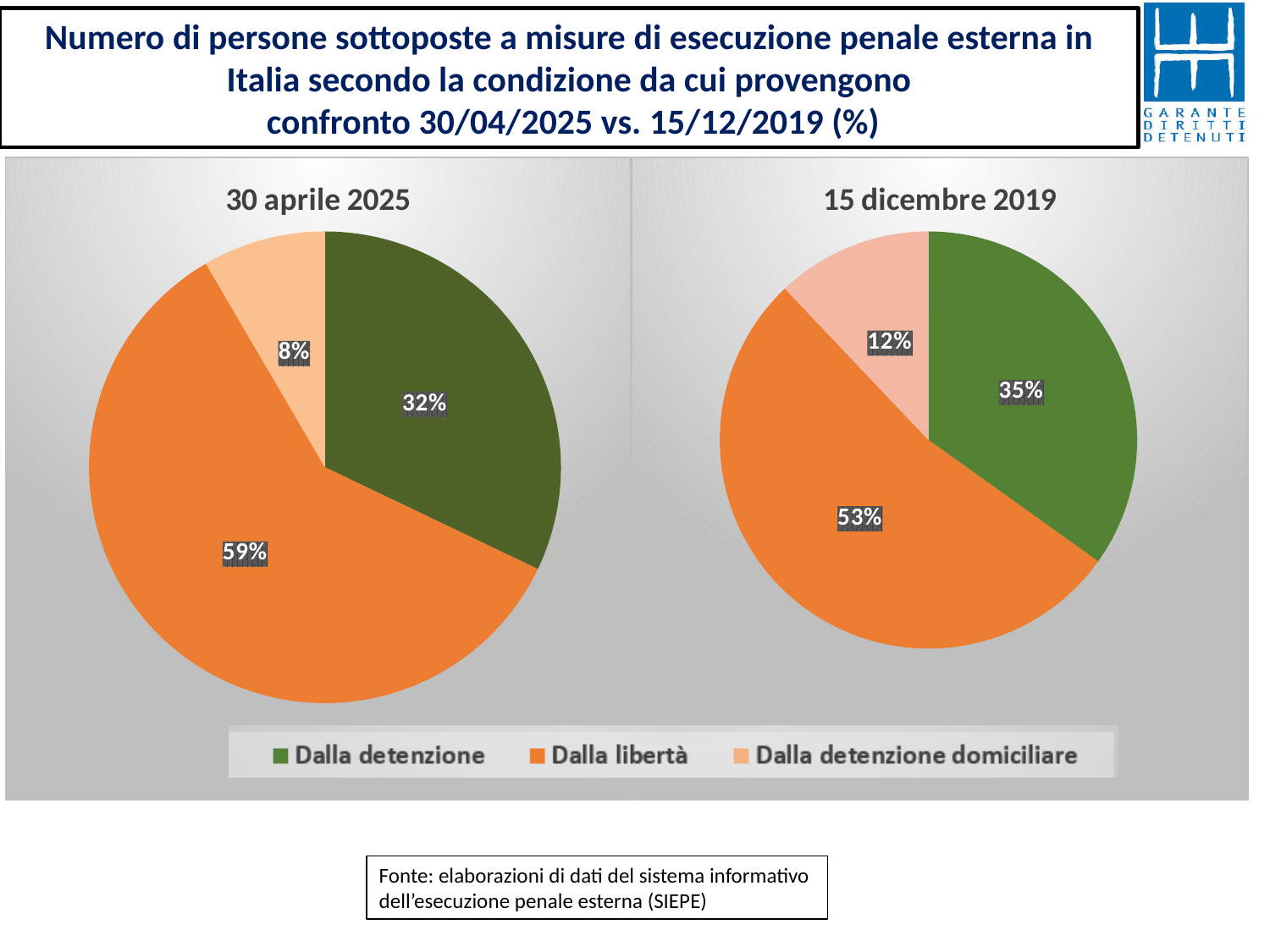
In the '15 dicembre 2019' pie chart, what share is 'Dalla detenzione'? 35% In the '30 aprile 2025' pie chart, what share is 'Dalla detenzione'? 32% In the '30 aprile 2025' pie chart, what is the difference in percentage points between 'Dalla libertà' and 'Dalla detenzione'? 27 What kind of chart is used on the slide? Pie chart In the '30 aprile 2025' pie chart, which category has the largest share? Dalla libertà In the '15 dicembre 2019' pie chart, what share is 'Dalla detenzione domiciliare'? 12% In the '15 dicembre 2019' pie chart, what share is 'Dalla libertà'? 53% In the '15 dicembre 2019' pie chart, which category has the smallest share? Dalla detenzione domiciliare Which is larger: 'Dalla detenzione' in the '30 aprile 2025' chart or 'Dalla detenzione' in the '15 dicembre 2019' chart? 15 dicembre 2019 In the '30 aprile 2025' pie chart, what share is 'Dalla libertà'? 59% How many categories does the legend list for the pie charts? 3 In the '30 aprile 2025' pie chart, what share is 'Dalla detenzione domiciliare'? 8%